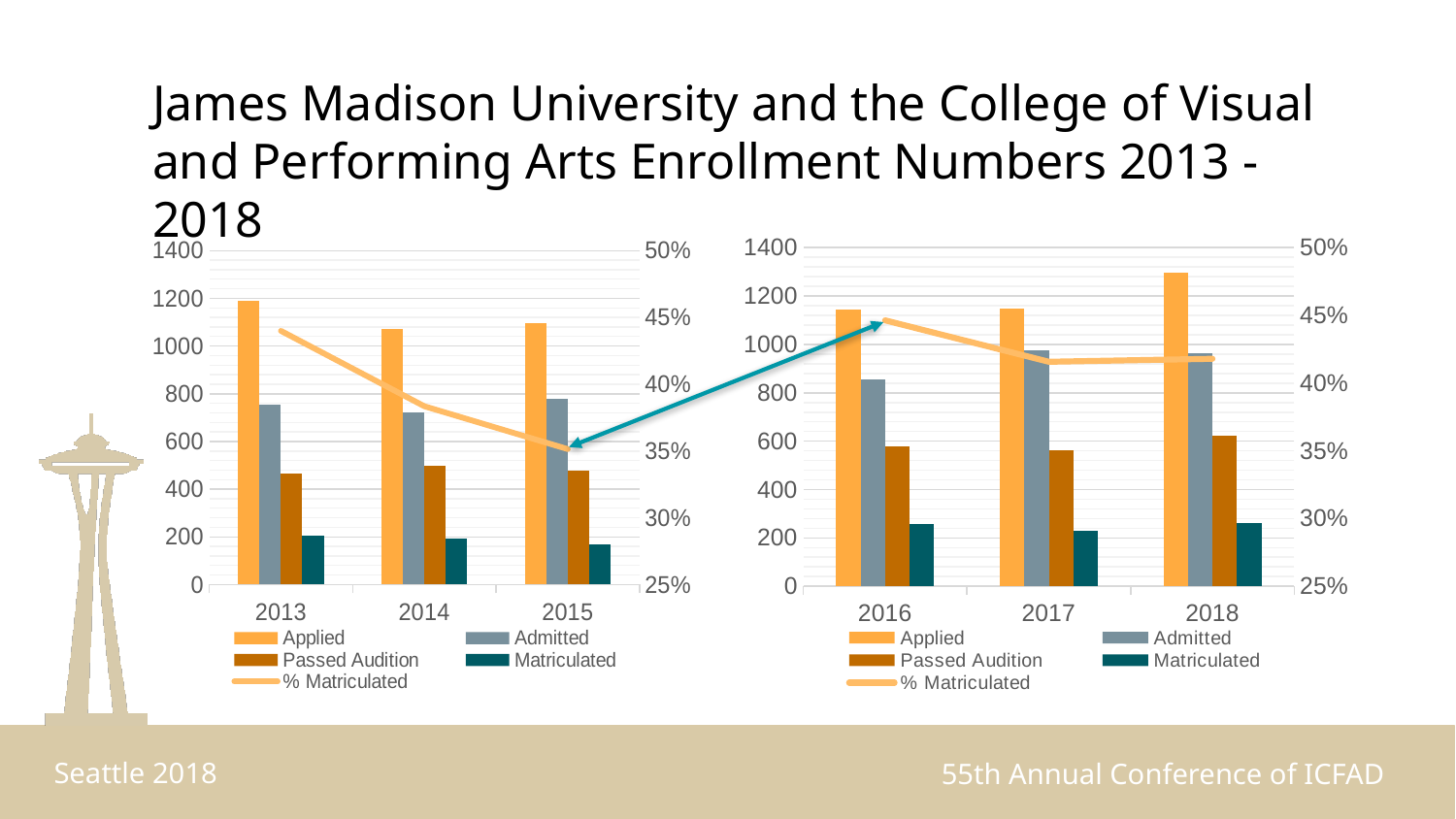
In the right chart (2016–2018), which year has the highest Applied value? 2018 In the left chart (2013–2015), which year has the highest Applied value? 2013 How many series does the legend of the left chart (2013–2015) list? 5 In the left chart (2013–2015), is the Applied value for 2013 greater or less than 1000? greater How many years are shown on the x axis of the left chart (2013–2015)? 3 In the left chart (2013–2015), is the Admitted value for 2015 greater or less than 600? greater In the right chart (2016–2018), which is larger in 2017, Admitted or Passed Audition? Admitted What kind of chart is the left chart (2013–2015)? combination bar and line chart In the left chart (2013–2015), does the % Matriculated line rise or fall from 2013 to 2015? fall In the right chart (2016–2018), is the Matriculated value for 2017 greater or less than 400? less